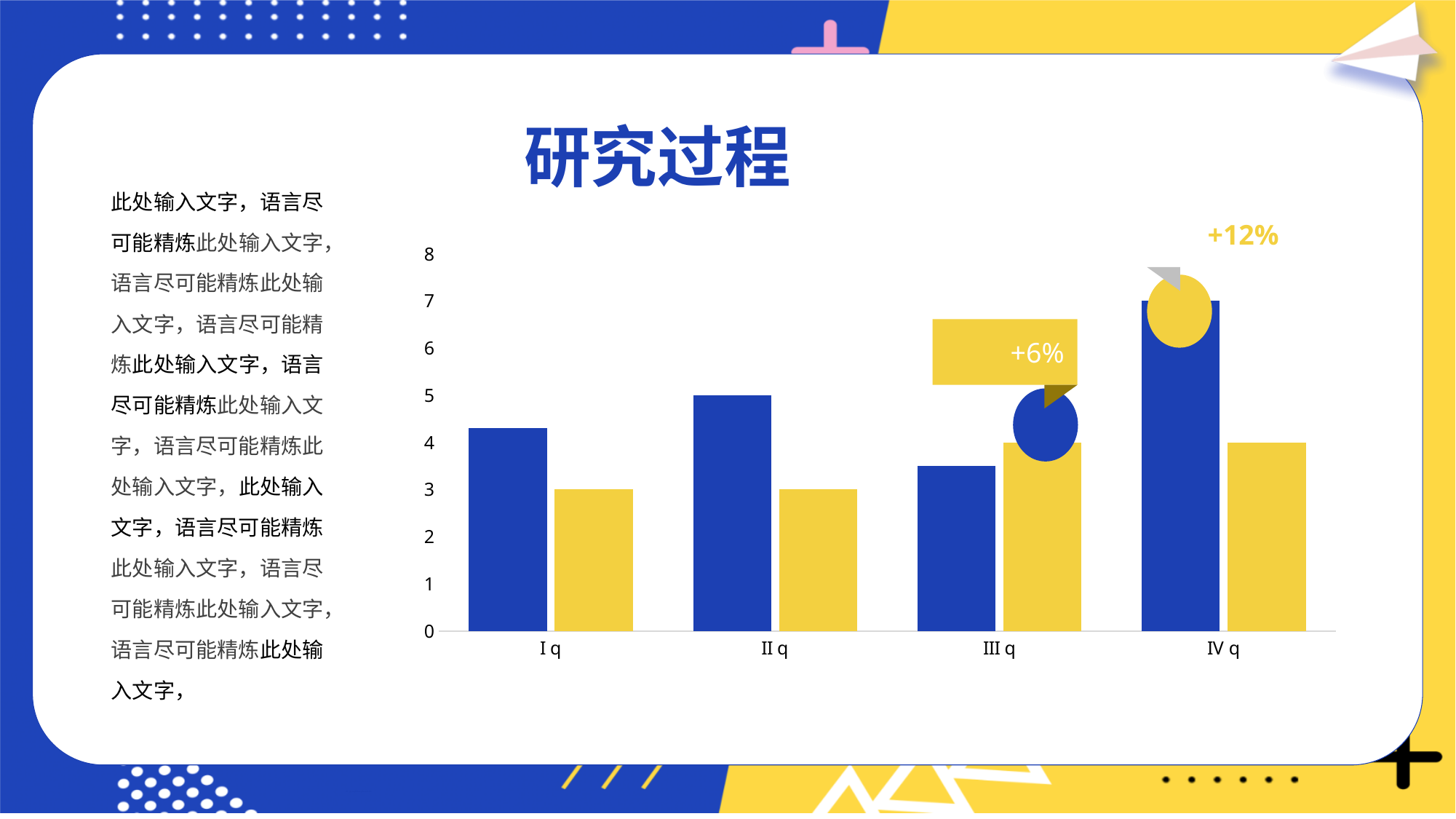
What is the value of the blue bar for II q? 5 What is the value of the yellow bar for IV q? 4 What is the value of the blue bar for IV q? 7 What is the title of the slide containing the chart? 研究过程 What kind of chart is shown on the slide? bar chart For III q, which bar is taller, the blue bar or the yellow bar? the yellow bar How many categories are shown on the x axis of the chart? 4 Which category has the tallest blue bar? IV q What percentage label is shown above the IV q bars? +12% Which category has the shortest blue bar? III q What is the difference between the blue bar and the yellow bar for IV q? 3 Is the value of the blue bar for I q greater or less than 4? greater